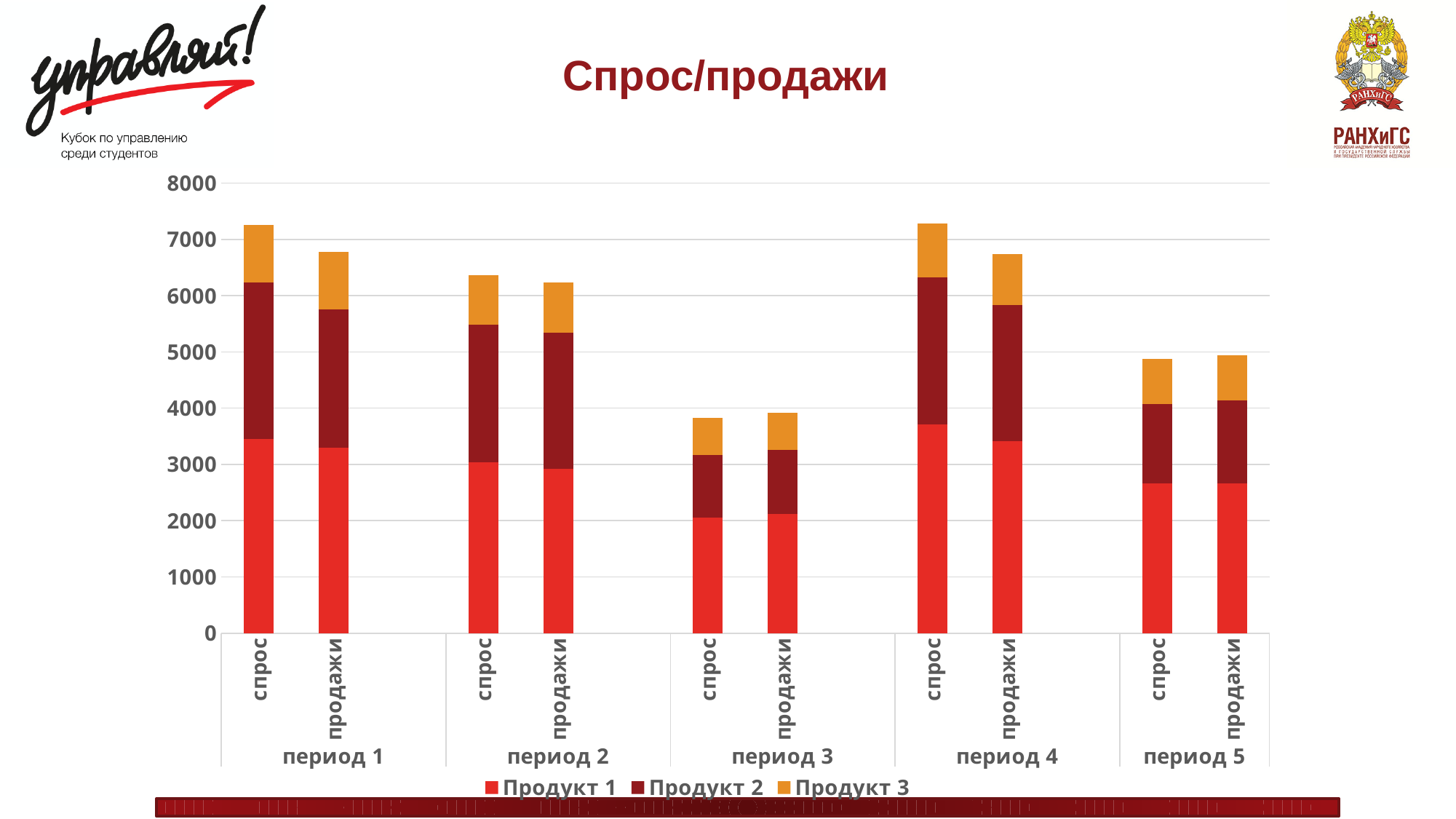
Is the total of the продажи bar in период 4 greater or less than 6000? greater In период 4, which bar is taller: спрос or продажи? спрос Which period has the lowest total продажи bar? период 3 What is the title of the chart? Спрос/продажи How many bars are plotted in total on the chart? 10 How many series does the legend list? 3 How many periods are shown on the x axis? 5 Is the total of the спрос bar in период 1 greater or less than 7000? greater What kind of chart is shown on the slide? stacked bar chart Is the total of the спрос bar in период 3 greater or less than 4000? less In период 1, which bar is taller: спрос or продажи? спрос Which period has the lowest total спрос bar? период 3